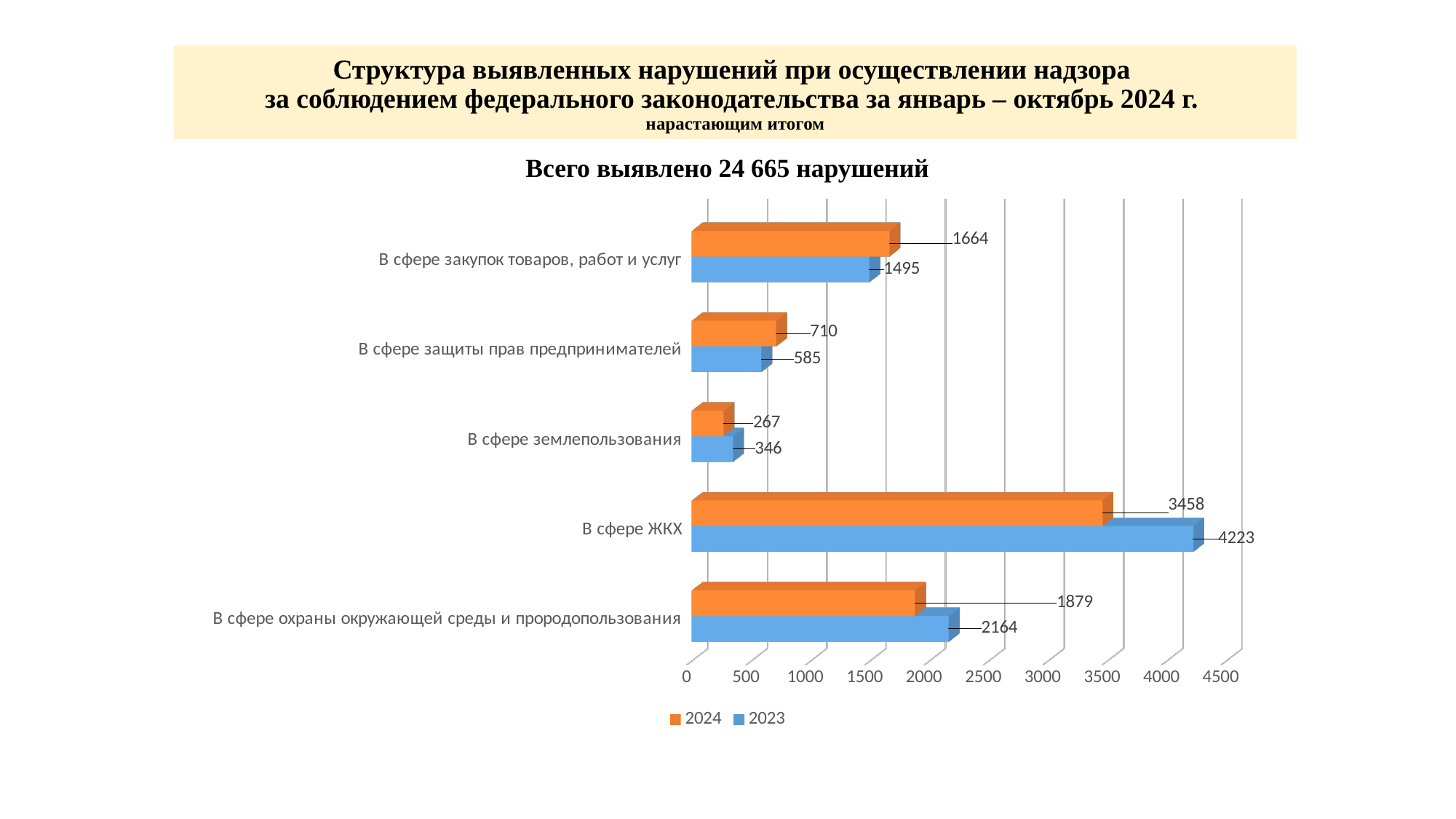
What is the 2023 value for В сфере закупок товаров, работ и услуг? 1495 What is the 2024 value for В сфере землепользования? 267 How many categories are shown on the chart? 5 Which is larger for В сфере защиты прав предпринимателей: the 2024 value or the 2023 value? 2024 What kind of chart is shown on the slide? Bar chart Which category has the highest 2023 value? В сфере ЖКХ What is the 2024 value for В сфере ЖКХ? 3458 What is the difference between the 2023 and 2024 values for В сфере ЖКХ? 765 How many series does the legend list? 2 Which colour represents the 2023 series? Blue Which category has the lowest 2024 value? В сфере землепользования What is the 2023 value for В сфере охраны окружающей среды и природопользования? 2164